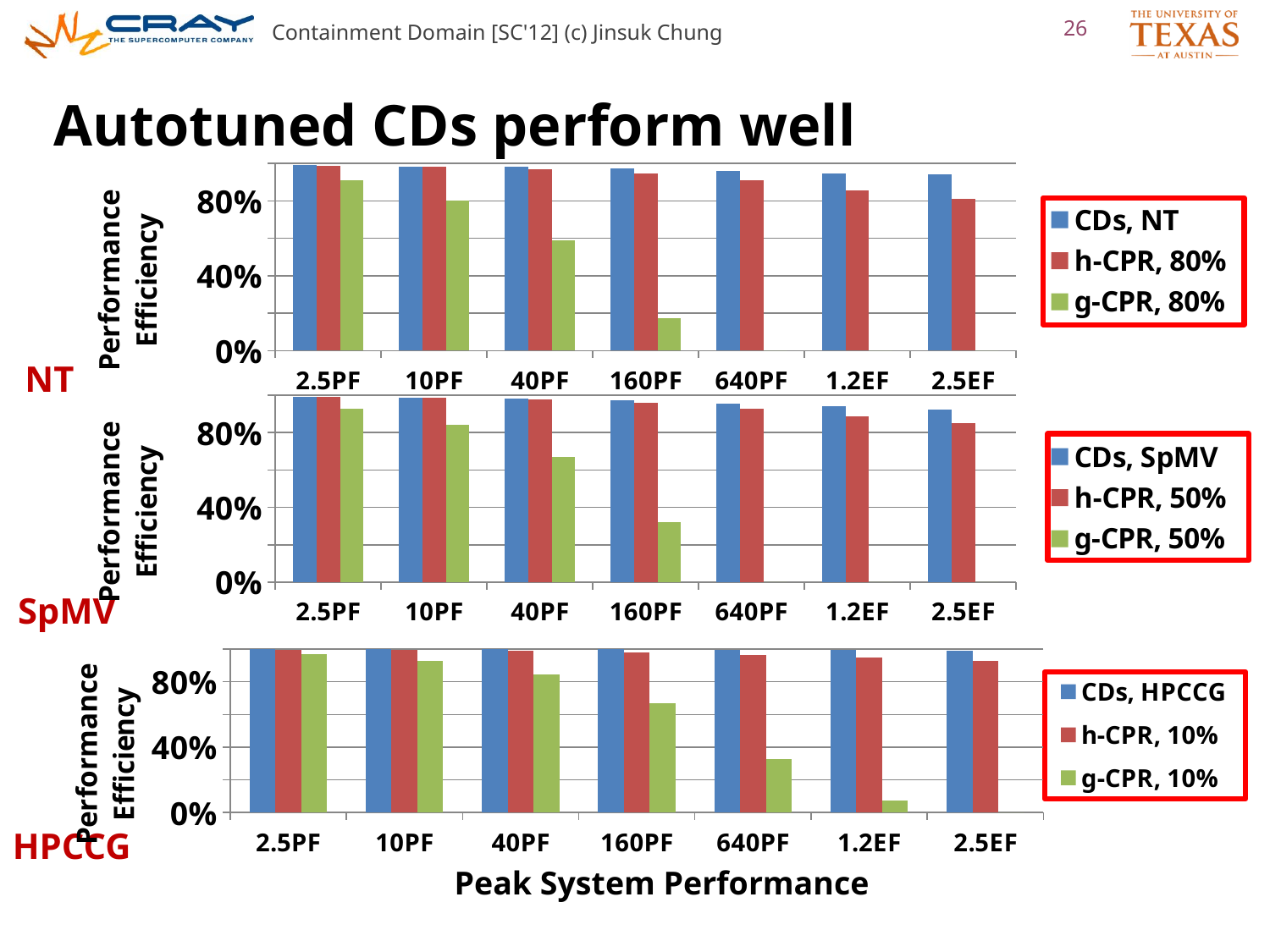
How many categories are shown on the x axis of the bottom (HPCCG) chart? 7 In the top (NT) chart, is the value for g-CPR, 80% at 40PF greater or less than 40%? greater In the top (NT) chart, which series has the lowest value at 160PF? g-CPR, 80% What kind of chart is the top (NT) chart on the slide? bar chart In the bottom (HPCCG) chart, is the value for g-CPR, 10% at 1.2EF greater or less than 40%? less In the middle (SpMV) chart, is the value for g-CPR, 50% at 160PF greater or less than 40%? less What is the x-axis title shown below the bottom chart? Peak System Performance How many series does the legend of the middle (SpMV) chart list? 3 In the bottom (HPCCG) chart, do the g-CPR, 10% values rise or fall as peak system performance increases along the x axis? fall In the top (NT) chart, which is larger at 2.5EF: CDs, NT or h-CPR, 80%? CDs, NT